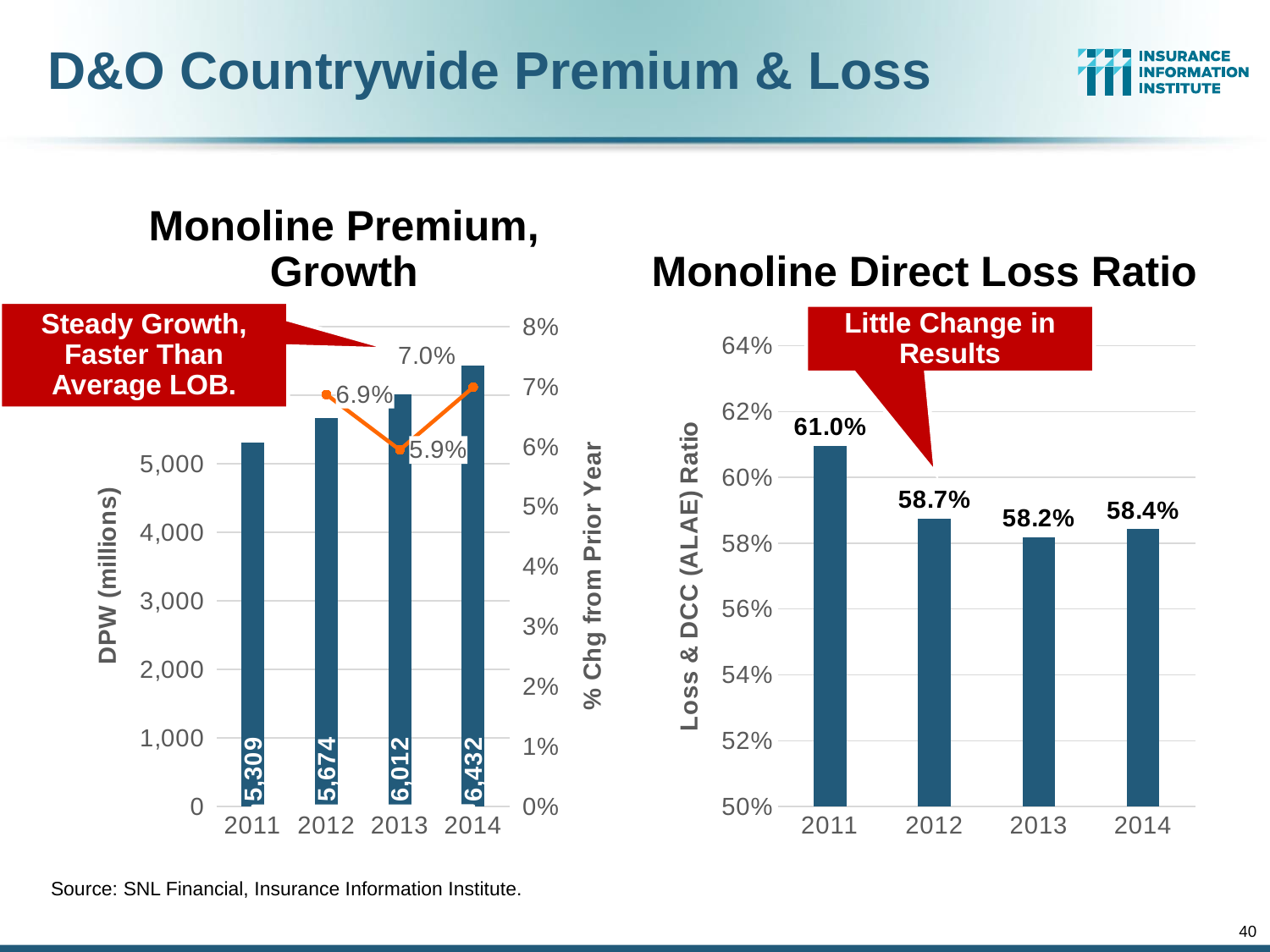
In the Monoline Premium, Growth chart, which year has the highest % change from prior year? 2014 In the Monoline Premium, Growth chart, what is the % change from prior year shown for 2013? 5.9% In the Monoline Premium, Growth chart, how many years are shown on the x axis? 4 In the Monoline Direct Loss Ratio chart, what is the difference between the 2011 and 2014 loss ratios? 2.6% In the Monoline Direct Loss Ratio chart, what is the loss ratio for 2012? 58.7% In the Monoline Premium, Growth chart, what is the DPW (millions) value for 2014? 6,432 In the Monoline Premium, Growth chart, what is the DPW (millions) value for 2011? 5,309 In the Monoline Direct Loss Ratio chart, which year has the lowest loss ratio? 2013 In the Monoline Direct Loss Ratio chart, which year has the highest loss ratio? 2011 In the Monoline Premium, Growth chart, what is the difference in DPW (millions) between 2014 and 2013? 420 What type of chart is the Monoline Direct Loss Ratio chart? bar chart In the Monoline Premium, Growth chart, do the DPW bars rise or fall from 2011 to 2014? rise